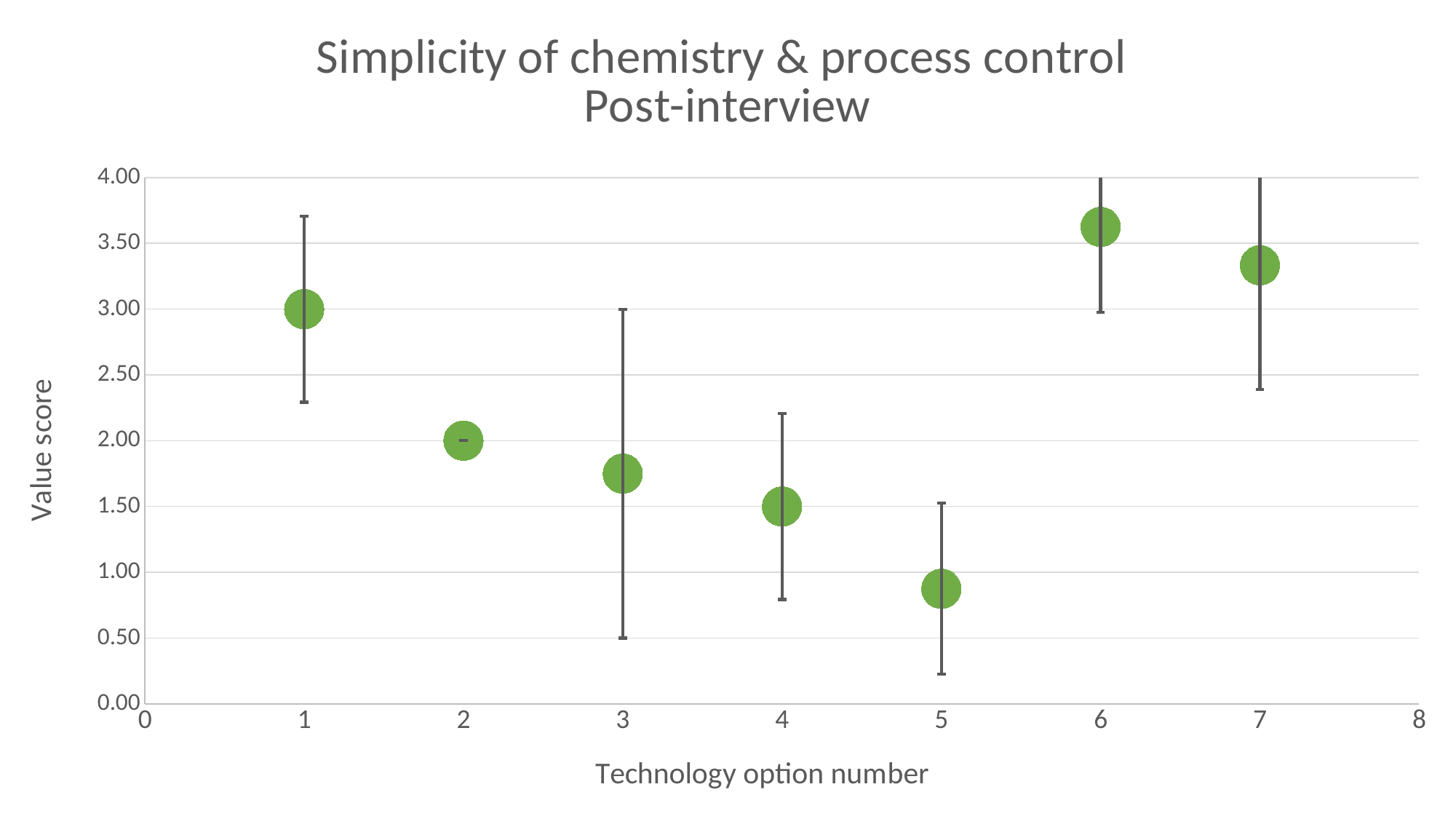
What is the value score for technology option 2? 2.00 Which technology option has the lowest value score? 5 What is the value score for technology option 4? 1.50 Is the value score for technology option 5 greater or less than 1.00? less Which technology option has the highest value score? 6 Is the value score for technology option 6 greater or less than 3.50? greater What is the value score for technology option 1? 3.00 What is the label on the vertical axis of the chart? Value score How many technology options are plotted on the chart? 7 Which has a higher value score, technology option 6 or technology option 7? 6 What type of chart is shown on the slide? Scatter chart What is the difference between the value scores of technology option 1 and technology option 2? 1.00